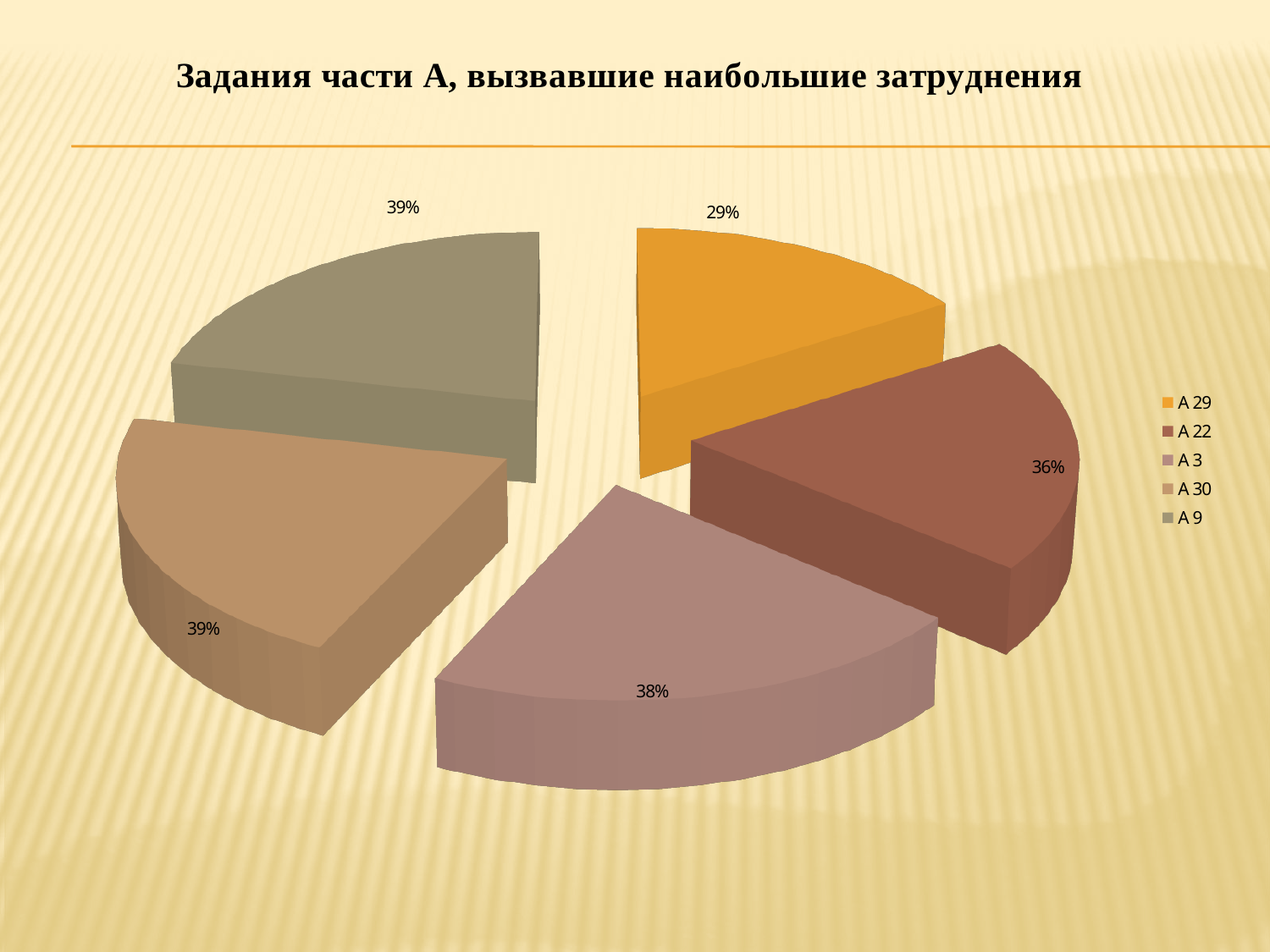
What is the value shown for A 22? 36% What type of chart is shown on the slide? pie chart What is the value shown for A 30? 39% Which category is shown in orange in the legend? A 29 What is the title of the chart on the slide? Задания части А, вызвавшие наибольшие затруднения What is the value shown for A 29? 29% What is the difference between the values for A 30 and A 29? 10% Which is larger, the value for A 3 or the value for A 22? A 3 How many categories does the pie chart have? 5 Which category has the lowest value? A 29 What is the value shown for A 9? 39% What is the value shown for A 3? 38%